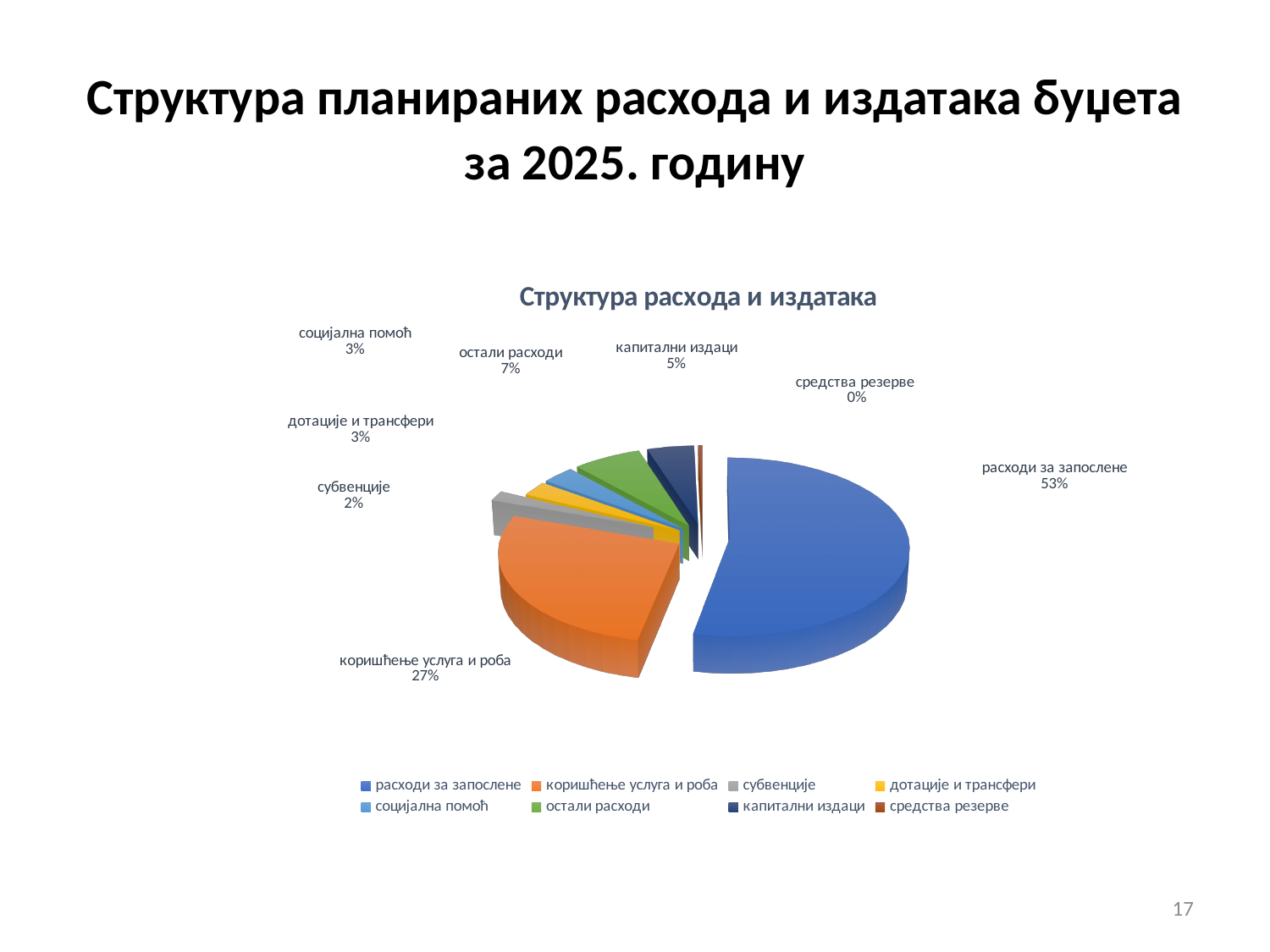
What is the title of the chart? Структура расхода и издатака Which category has the smallest share of the pie? средства резерве What share of the pie does 'коришћење услуга и роба' have? 27% What share of the pie does 'расходи за запослене' have? 53% What is the value shown for 'остали расходи'? 7% Which category has the largest share of the pie? расходи за запослене What is the difference between the shares of 'расходи за запослене' and 'коришћење услуга и роба'? 26% What is the value shown for 'капитални издаци'? 5% Which is larger, the share for 'остали расходи' or the share for 'капитални издаци'? остали расходи What is the value shown for 'средства резерве'? 0% How many categories does the pie chart show? 8 What type of chart is shown on the slide? Pie chart